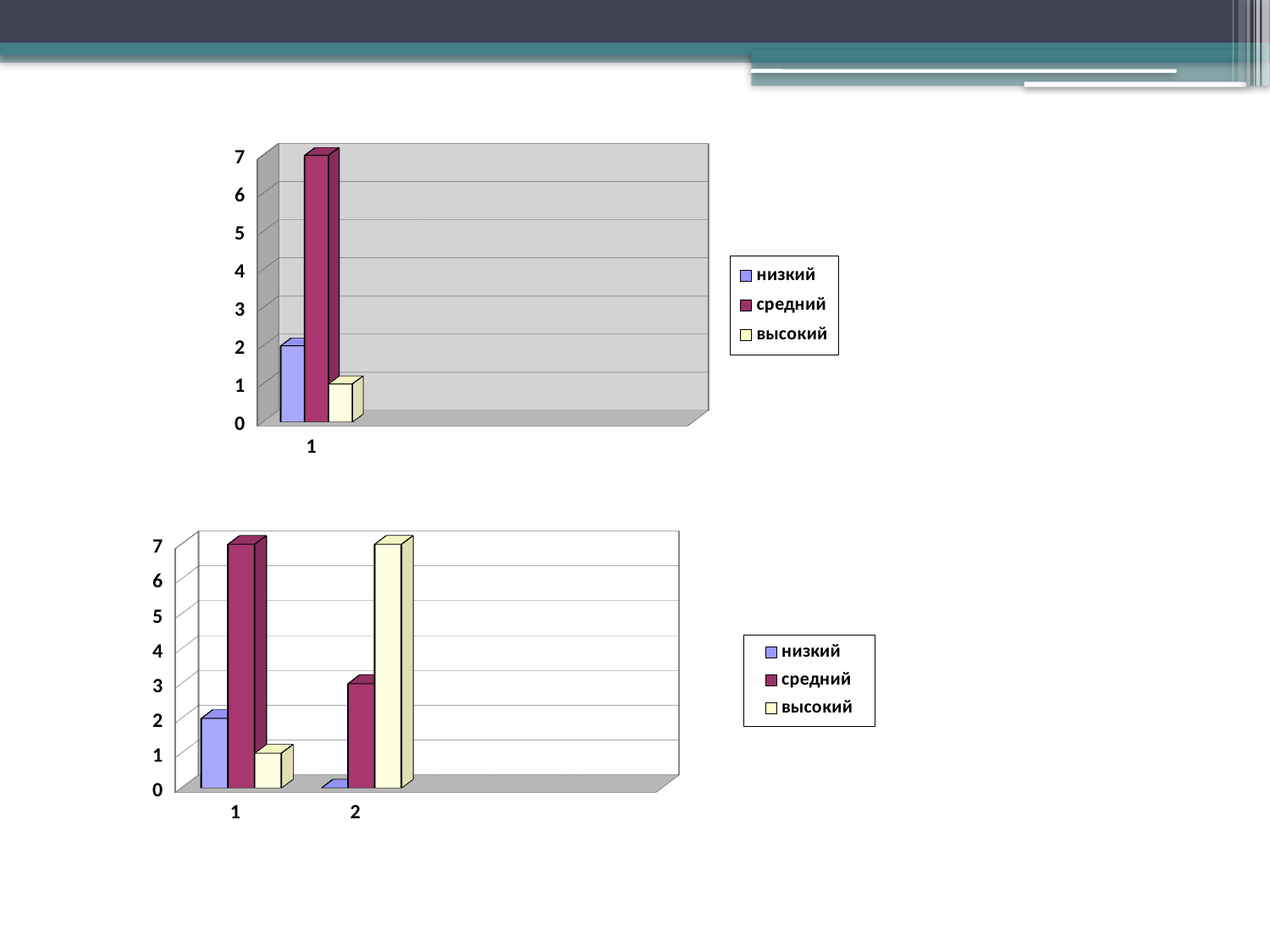
In the bottom chart, which is larger for category 1: средний or высокий? средний In the top chart, is the value for средний greater or less than 5? greater In the bottom chart, is the value for средний in category 2 greater or less than 5? less How many categories are shown on the x axis of the bottom chart? 2 In the top chart, which series has the lowest bar for category 1? высокий In the bottom chart, which series has the highest bar for category 2? высокий In the top chart, is the value for низкий greater or less than 4? less In the bottom chart, which series has the lowest bar for category 2? низкий How many series does the legend of the top chart list? 3 What are the three legend entries of the bottom chart? низкий, средний, высокий In the top chart, which series has the highest bar for category 1? средний What kind of chart is the top chart on the slide? bar chart